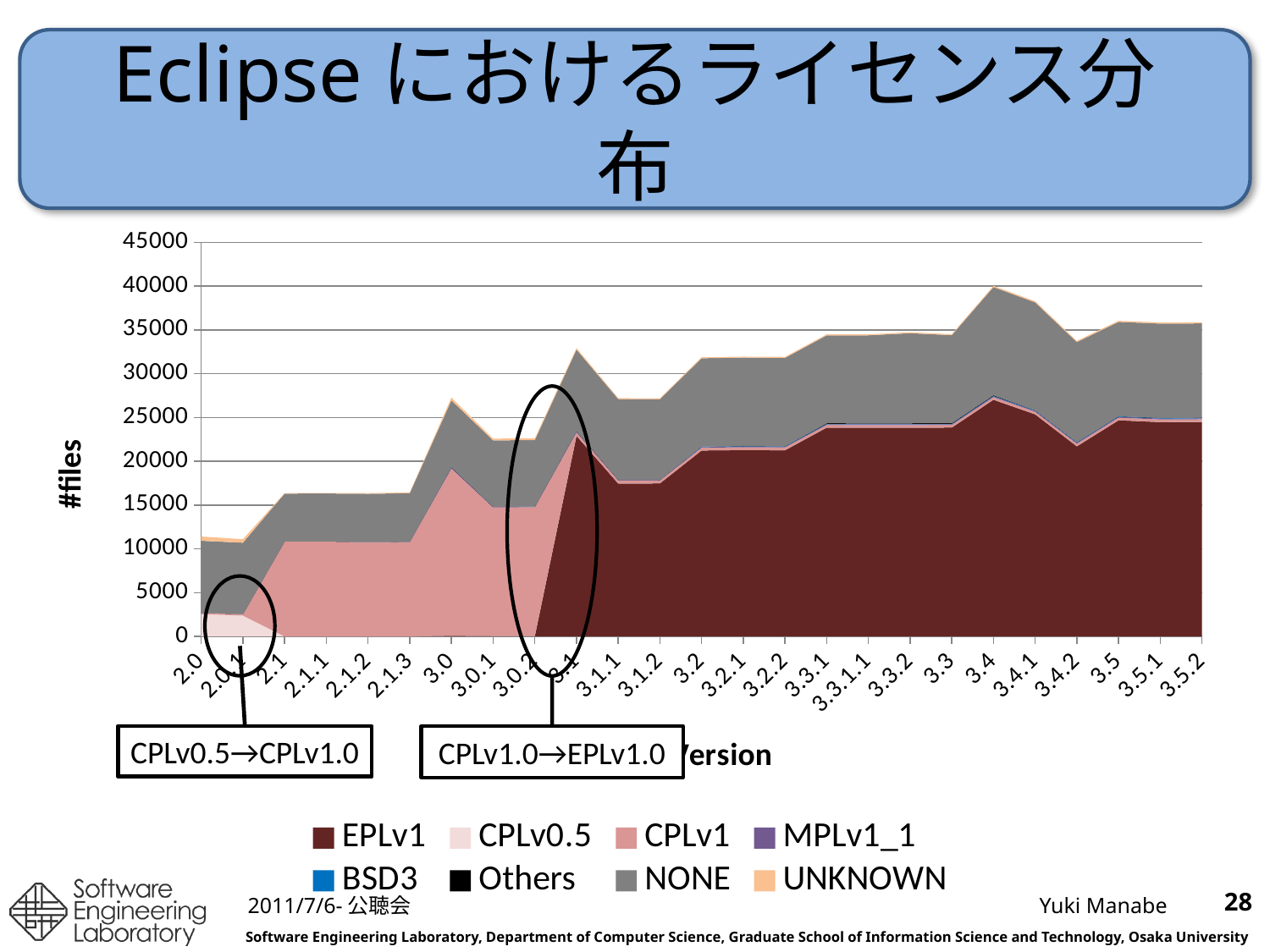
What kind of chart is shown on the slide? area chart Is the CPLv1 value for version 3.0 greater or less than 15000? greater Which version has a larger total number of files, 3.4 or 3.0? 3.4 Is the total number of files for version 3.4 greater or less than 35000? greater Is the EPLv1 value for version 3.5.2 greater or less than 20000? greater What is the label of the y axis? #files Which version has the highest total number of files? 3.4 How many series does the legend list? 8 Does the total number of files generally rise or fall from version 2.0 to version 3.5.2? rise What is the highest value shown on the y axis? 45000